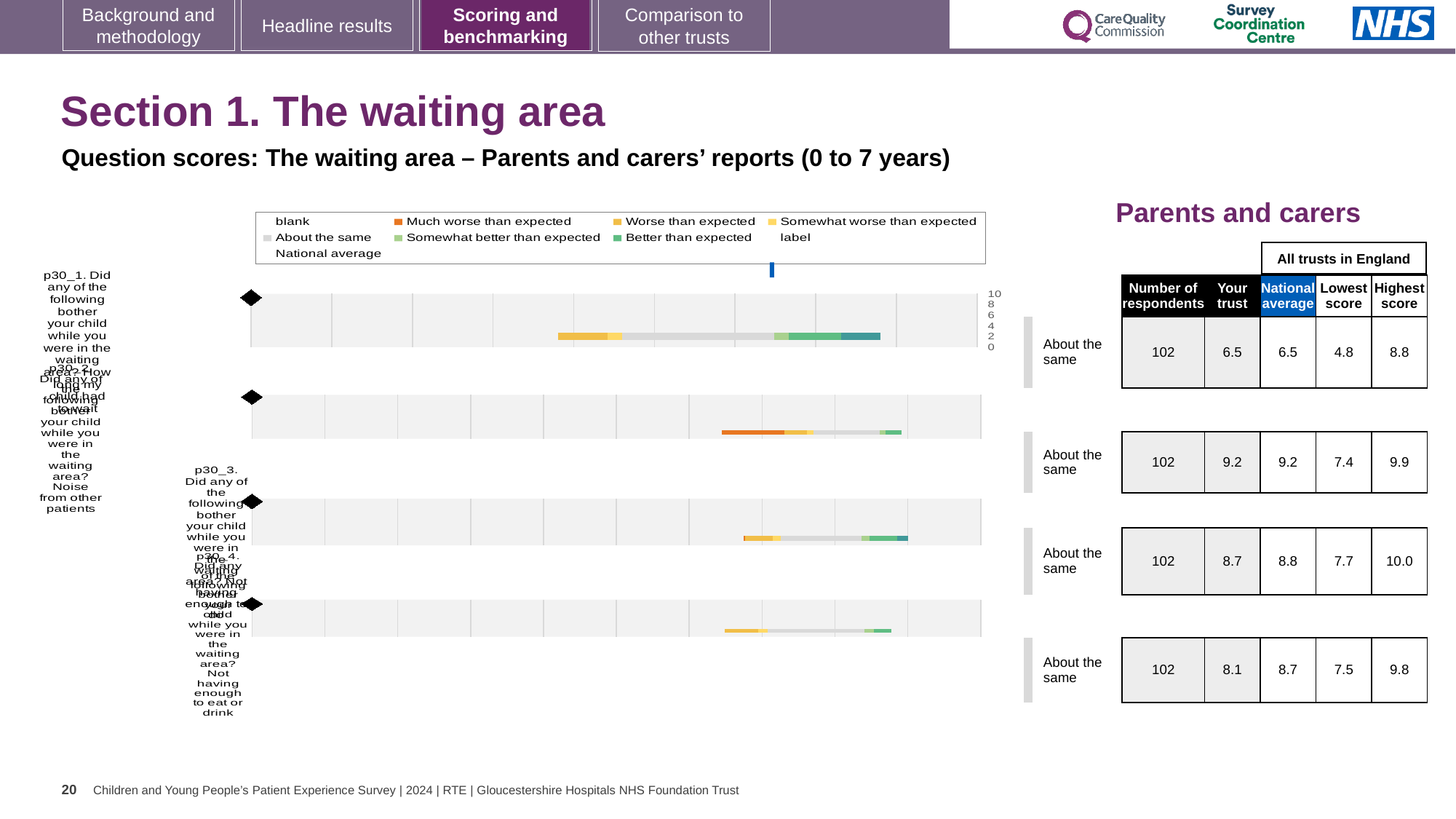
In the table next to the charts, what is the difference between the national average and the 'Your trust' score for the fourth question row? 0.6 What kind of chart is used to show the question scores on this slide? bar chart In the table next to the charts, which question row has the lowest 'Your trust' score? the first row (6.5) How many respondents are listed for each question row in the table next to the charts? 102 How many question bar charts are shown on the slide? 4 In the table next to the charts, which question row has the highest 'Your trust' score? the second row (9.2) In the table next to the charts, what is the 'Your trust' score for the fourth question row? 8.1 In the table next to the charts, what is the highest score for the second question row? 9.9 In the table next to the charts, what is the national average for the third question row? 8.8 In the table next to the charts, what is the 'Your trust' score for the second question row? 9.2 In the table next to the charts, what is the 'Your trust' score for the first question row? 6.5 In the table next to the charts, what is the lowest score for the first question row? 4.8